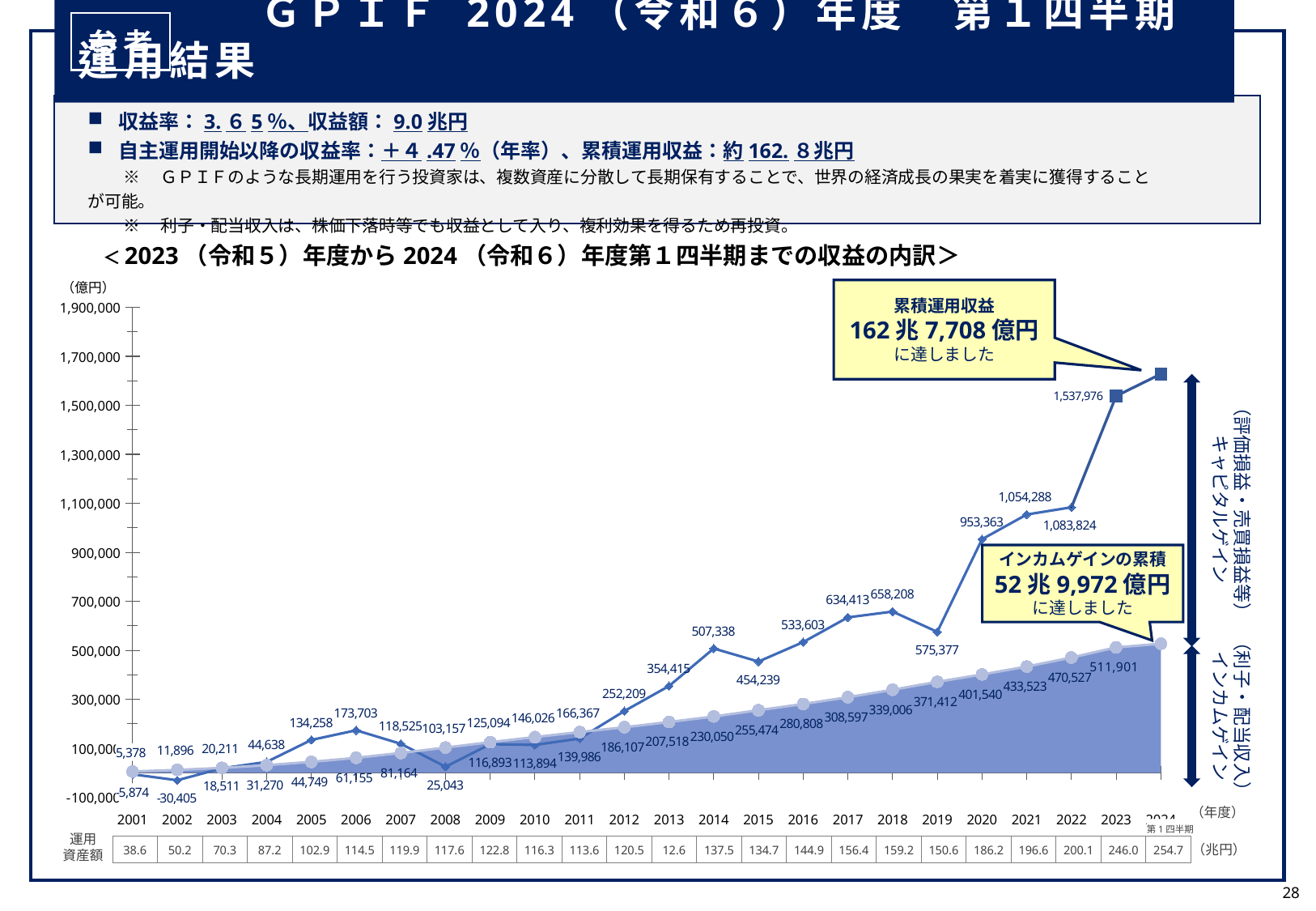
What is the cumulative investment return (line series) data label for 2020? 953,363 What is the difference between the cumulative investment return labels for 2023 and 2022? 454,152 What kind of chart is used to show the returns breakdown? line chart with a shaded area Is the cumulative investment return for 2024 (first quarter) greater or less than 1,500,000? greater What is the income gain (shaded area) data label for 2022? 470,527 What is the income gain (shaded area) data label for 2023? 511,901 According to the callout, what amount has the cumulative income gain (インカムゲインの累積) reached? 52兆9,972億円 According to the callout, what amount has the cumulative investment return (累積運用収益) reached? 162兆7,708億円 In which year does the cumulative investment return line show its lowest (negative) value? 2002 What is the cumulative investment return (line series) data label for 2023? 1,537,976 Which is larger, the cumulative investment return for 2014 or for 2015? 2014 What is the cumulative investment return (line series) data label for 2022? 1,083,824